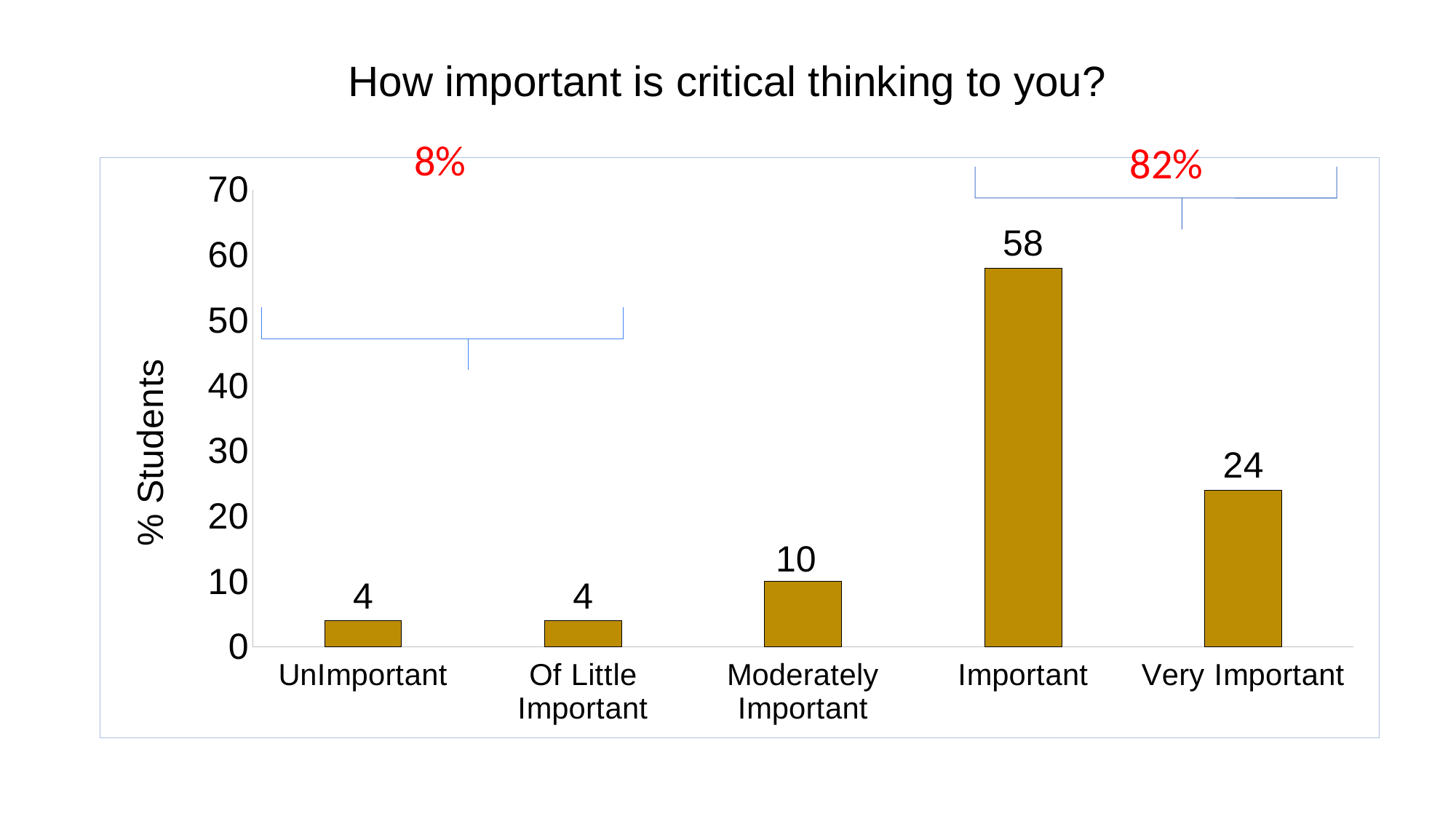
Is the value for Important greater or less than 50? greater What is the value for Moderately Important? 10 What is the value for UnImportant? 4 What is the difference between the values for Important and Very Important? 34 What is the title of the chart? How important is critical thinking to you? Which is larger, the value for Moderately Important or the value for Very Important? Very Important What is the label of the y axis? % Students Which category has the highest value? Important What kind of chart is shown on the slide? bar chart How many categories are shown on the x axis? 5 What is the value for Very Important? 24 What is the value for Important? 58